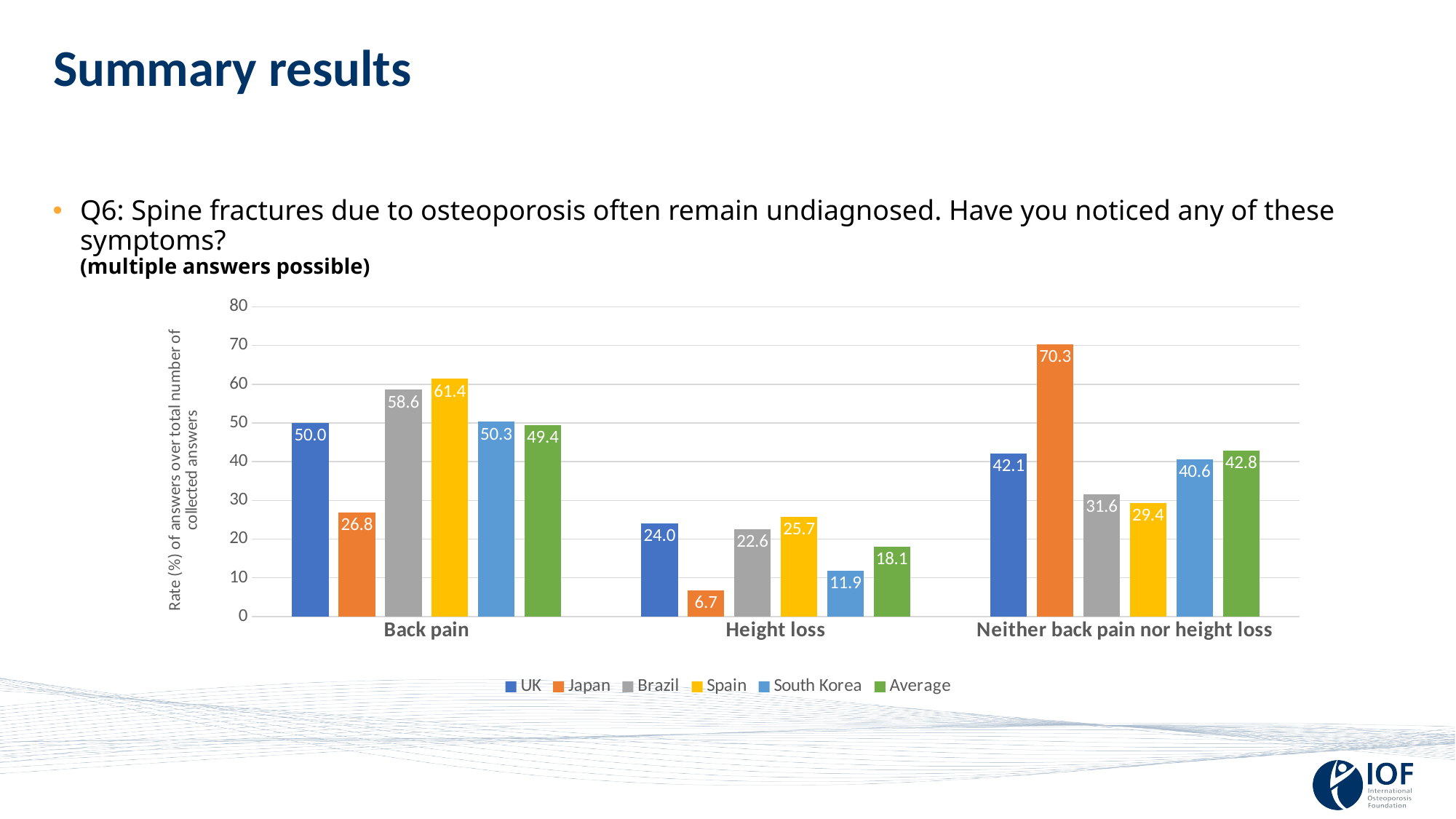
What kind of chart is shown on the slide? Bar chart What is the label of the y axis? Rate (%) of answers over total number of collected answers What is the value for South Korea in the Neither back pain nor height loss category? 40.6 What is the value for Spain in the Height loss category? 25.7 Which is larger in the Back pain category, the value for Brazil or the value for South Korea? Brazil Which series has the lowest value in the Height loss category? Japan Which series has the highest value in the Neither back pain nor height loss category? Japan What is the difference between the Spain and UK values in the Back pain category? 11.4 How many series does the legend list? 6 How many categories are shown on the x axis? 3 What is the value for Japan in the Back pain category? 26.8 Is the value for Japan in the Neither back pain nor height loss category greater or less than 60? greater